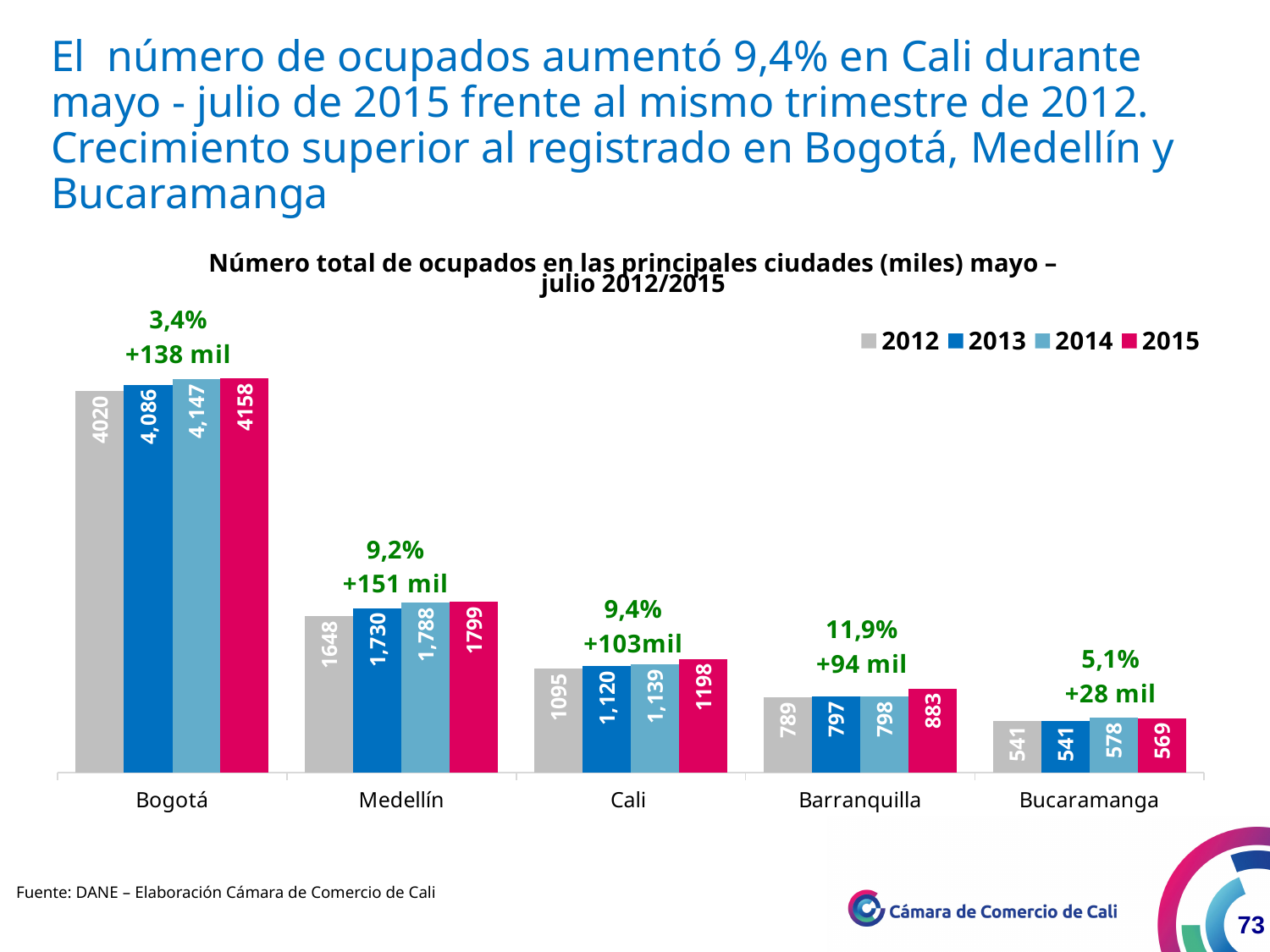
How many cities are shown on the x axis? 5 Which city has the highest value in 2015? Bogotá What type of chart is shown on the slide? Bar chart Do the values for Medellín rise or fall from 2012 to 2015? Rise How many series does the legend list? 4 What percentage growth is annotated above the Barranquilla bars? 11,9% What is the value for Barranquilla in 2012? 789 Which is larger, the 2014 value for Bucaramanga or the 2015 value for Bucaramanga? 2014 value (578) Which city has the lowest value in 2014? Bucaramanga What is the value for Cali in 2015? 1198 What is the difference between the 2015 and 2012 values for Cali? 103 What is the value for Medellín in 2013? 1,730